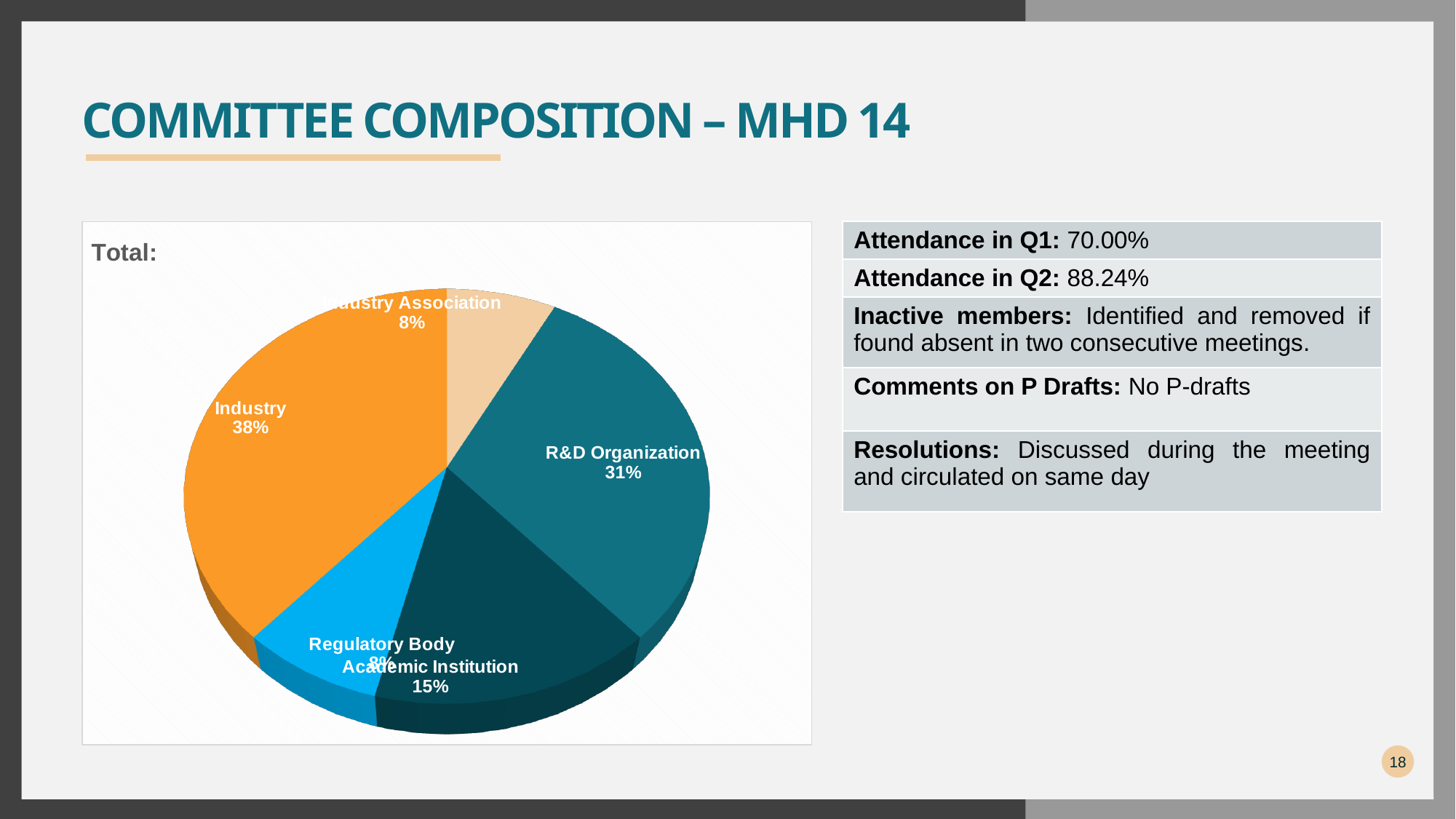
What percentage is shown for R&D Organization? 31% What percentage is shown for Industry Association? 8% What percentage is shown for Academic Institution? 15% How many slices does the pie chart have? 5 What is the title shown on the chart? Total: Which is larger, the R&D Organization slice or the Academic Institution slice? R&D Organization What type of chart is shown on the slide? Pie chart Which category has the largest slice of the pie? Industry What is the difference between the R&D Organization and Academic Institution shares? 16% Which is smaller, Academic Institution or Industry Association? Industry Association What share of the pie does Industry hold? 38% By how many percentage points does Industry exceed R&D Organization? 7%